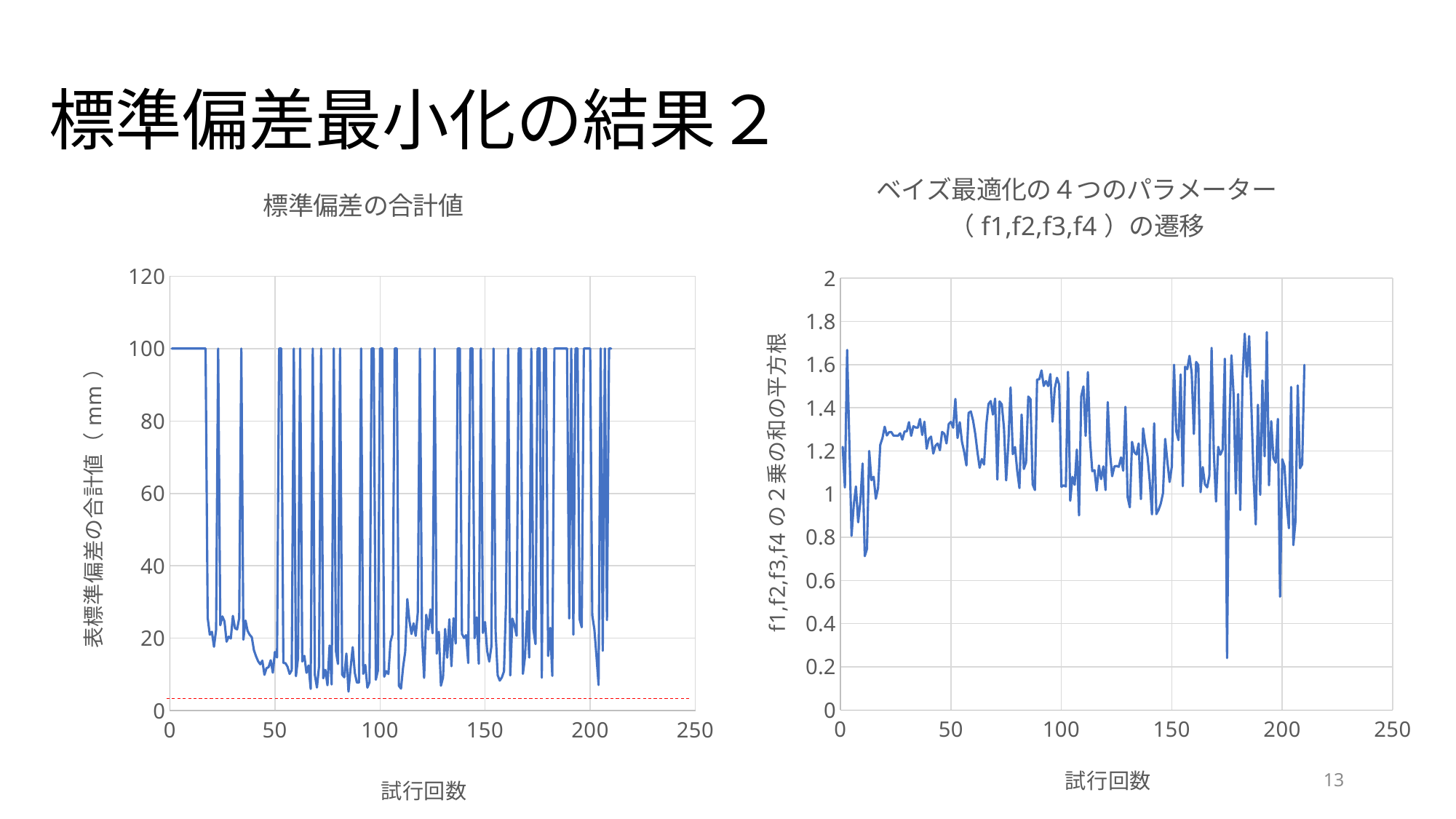
What is the x-axis label of the left chart (標準偏差の合計値)? 試行回数 In the left chart (標準偏差の合計値), what value does the line hold for the first trials before it first drops? 100 What kind of chart is the left chart titled 標準偏差の合計値? line chart What is the maximum value shown on the y-axis of the right chart (ベイズ最適化の４つのパラメーターの遷移)? 2 In the left chart (標準偏差の合計値), is the highest value reached by the line greater or less than 80? greater In the right chart (ベイズ最適化の４つのパラメーターの遷移), is the lowest value reached by the line greater or less than 0.4? less In the left chart (標準偏差の合計値), is the lowest value reached by the line greater or less than 20? less How many lines are plotted in the left chart (標準偏差の合計値)? 1 What kind of chart is the right chart titled ベイズ最適化の４つのパラメーター（f1,f2,f3,f4）の遷移? line chart